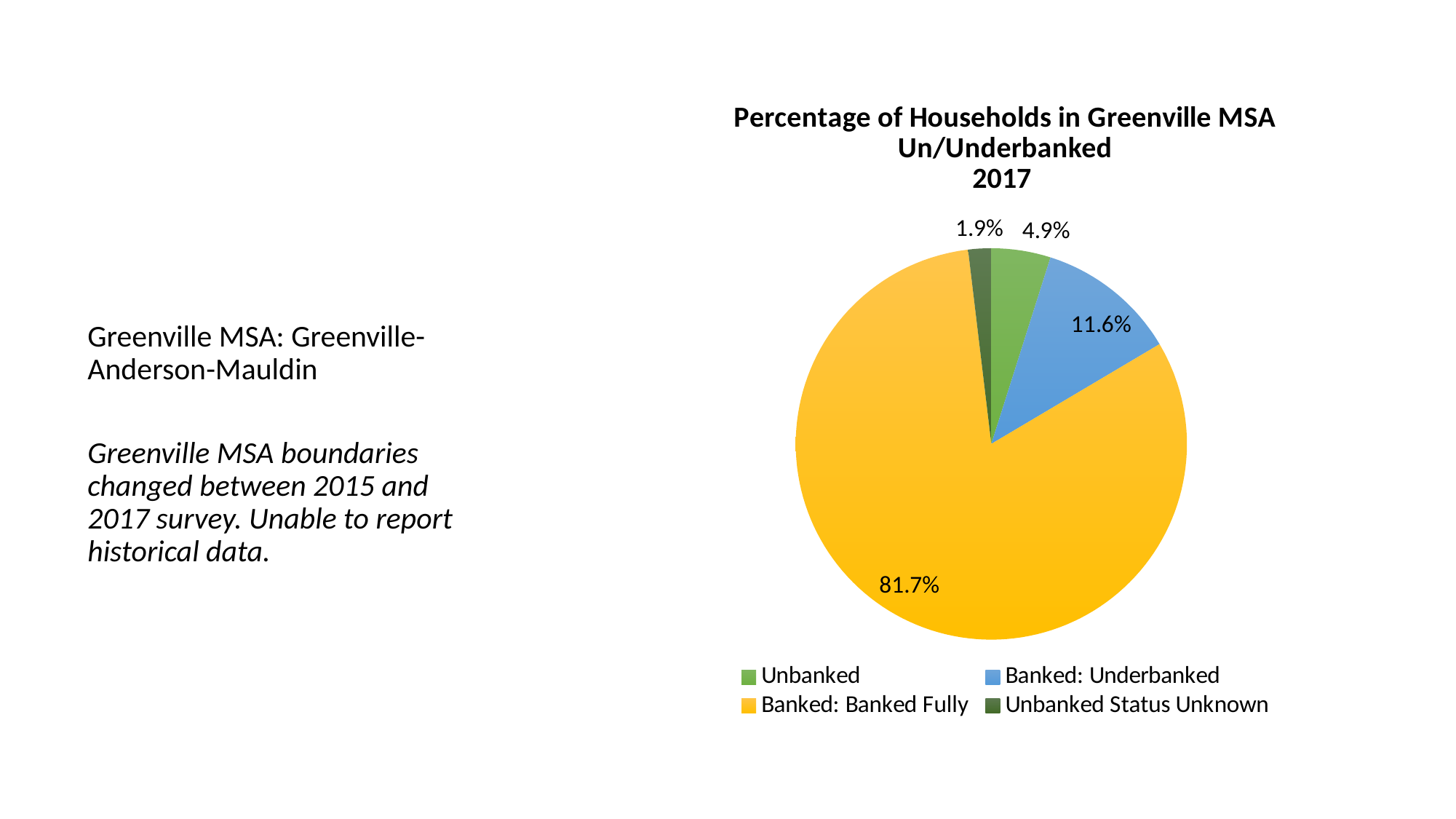
What percentage of households in the Greenville MSA are Banked: Banked Fully? 81.7% Which is larger, the Unbanked share or the Unbanked Status Unknown share? Unbanked Which category has the largest share of the pie? Banked: Banked Fully What year does the chart title say the data is for? 2017 What kind of chart is shown on the slide? Pie chart What percentage of households in the Greenville MSA have Unbanked Status Unknown? 1.9% What is the difference in percentage points between Banked: Underbanked and Unbanked? 6.7 Which category has the smallest share of the pie? Unbanked Status Unknown How many slices does the pie chart have? 4 How many entries does the legend list? 4 What percentage of households in the Greenville MSA are Unbanked? 4.9% What percentage of households in the Greenville MSA are Banked: Underbanked? 11.6%